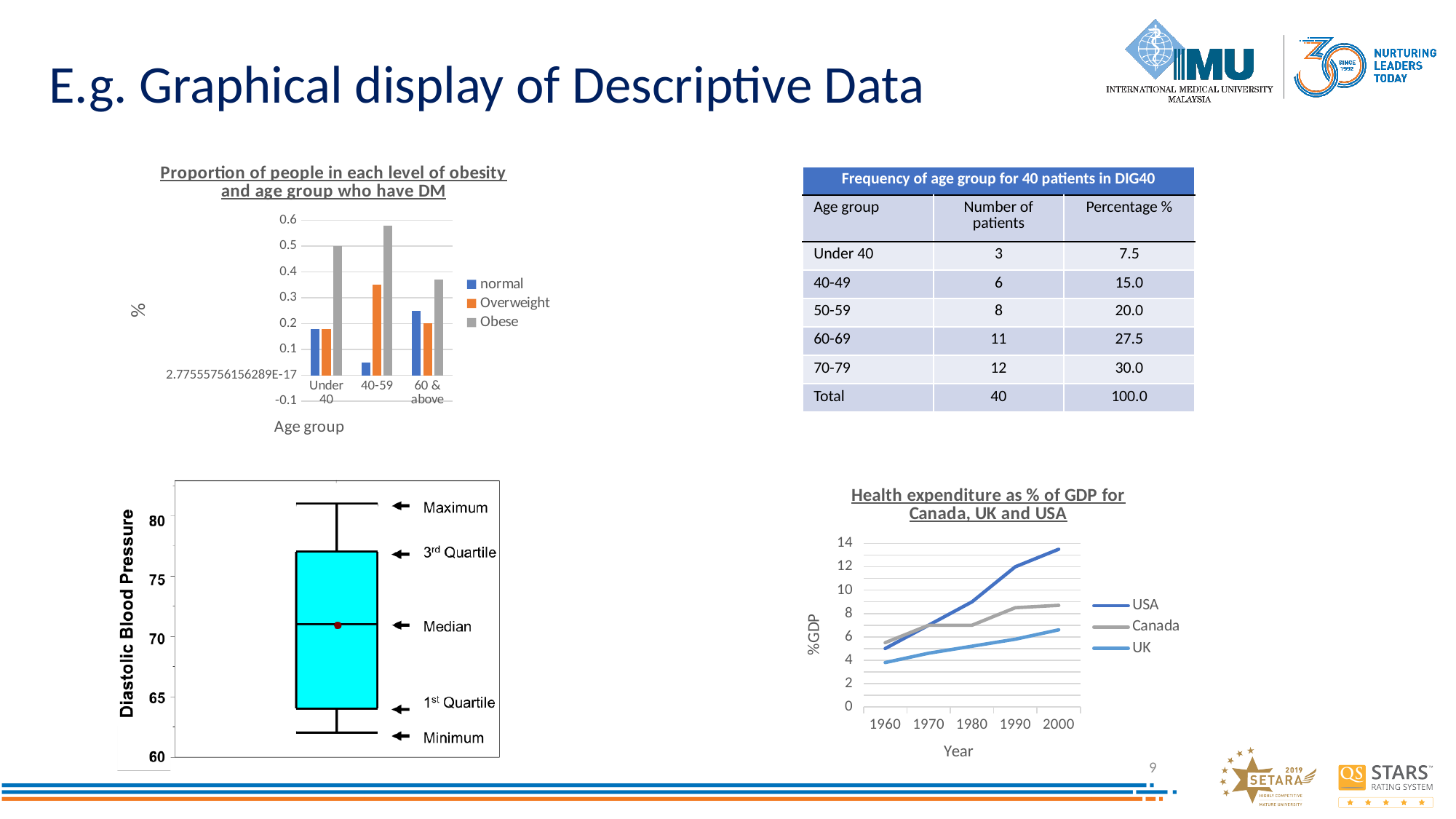
In the 'Proportion of people in each level of obesity and age group who have DM' chart, which series has the highest bar in the 40-59 age group? Obese How many series does the legend of the 'Proportion of people in each level of obesity and age group who have DM' chart list? 3 How many age group categories are shown on the x axis of the 'Proportion of people in each level of obesity and age group who have DM' chart? 3 In the 'Health expenditure as % of GDP for Canada, UK and USA' chart, does the USA line rise or fall from 1960 to 2000? rise What kind of chart is the 'Health expenditure as % of GDP for Canada, UK and USA' chart? line chart How many series does the legend of the 'Health expenditure as % of GDP for Canada, UK and USA' chart list? 3 In the 'Proportion of people in each level of obesity and age group who have DM' chart, is the normal value for the 40-59 age group greater or less than 0.1? less What kind of chart is the 'Proportion of people in each level of obesity and age group who have DM' chart? bar chart In the 'Health expenditure as % of GDP for Canada, UK and USA' chart, which country has the lowest value in 2000? UK In the 'Health expenditure as % of GDP for Canada, UK and USA' chart, is the USA value in 2000 greater or less than 12? greater In the 'Proportion of people in each level of obesity and age group who have DM' chart, is the Obese value for the 40-59 age group greater or less than 0.5? greater In the 'Proportion of people in each level of obesity and age group who have DM' chart, which is larger for the 60 & above age group: normal or Overweight? normal